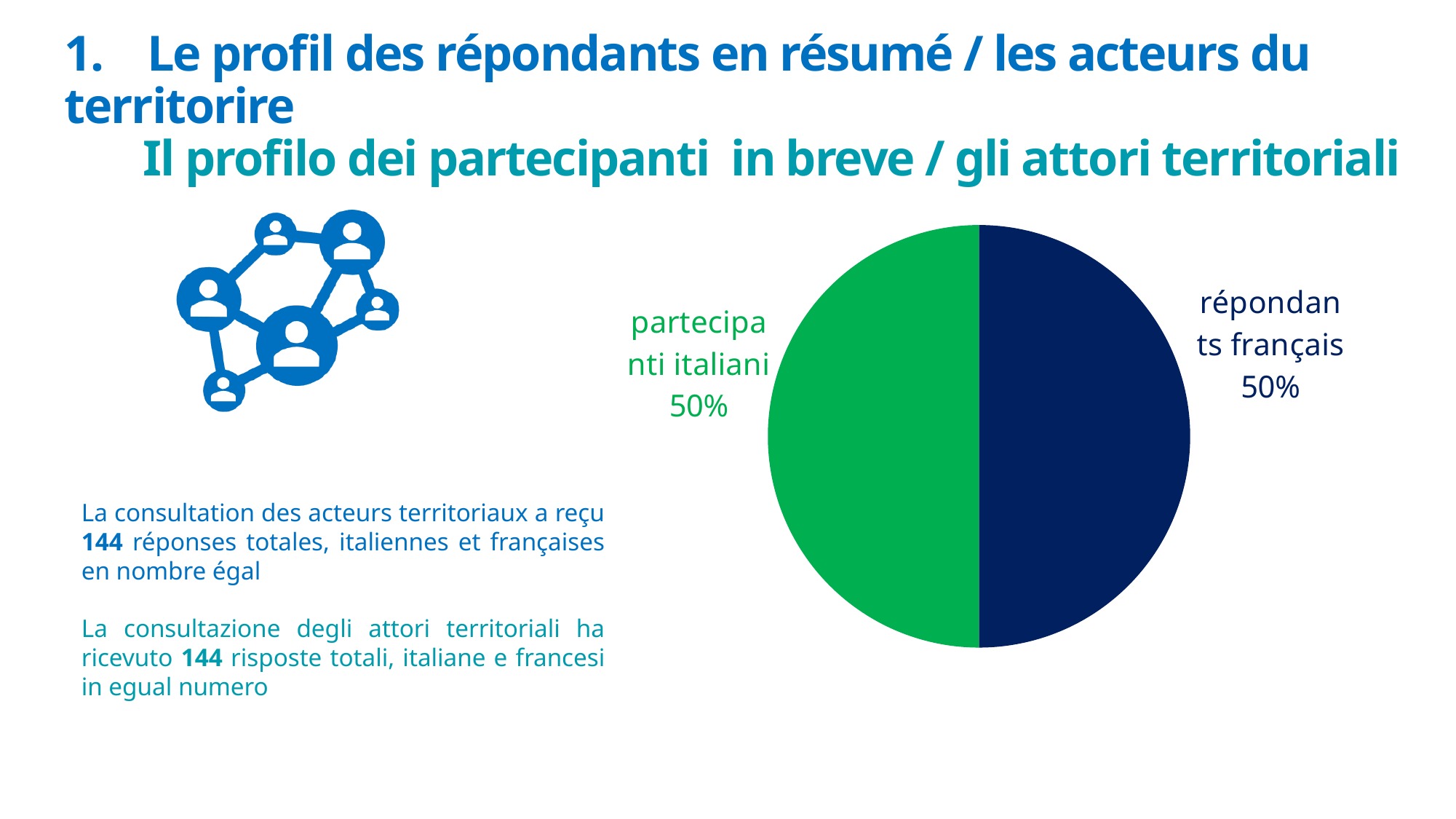
What share of the pie is labelled 'répondants français'? 50% What is the difference between the share for 'partecipanti italiani' and the share for 'répondants français'? 0% What colour is the slice for 'partecipanti italiani'? green What kind of chart is shown on the slide? pie chart What share of the pie is labelled 'partecipanti italiani'? 50% What is the combined share of the two slices in the pie chart? 100% How many slices does the pie chart have? 2 What colour is the slice for 'répondants français'? dark blue